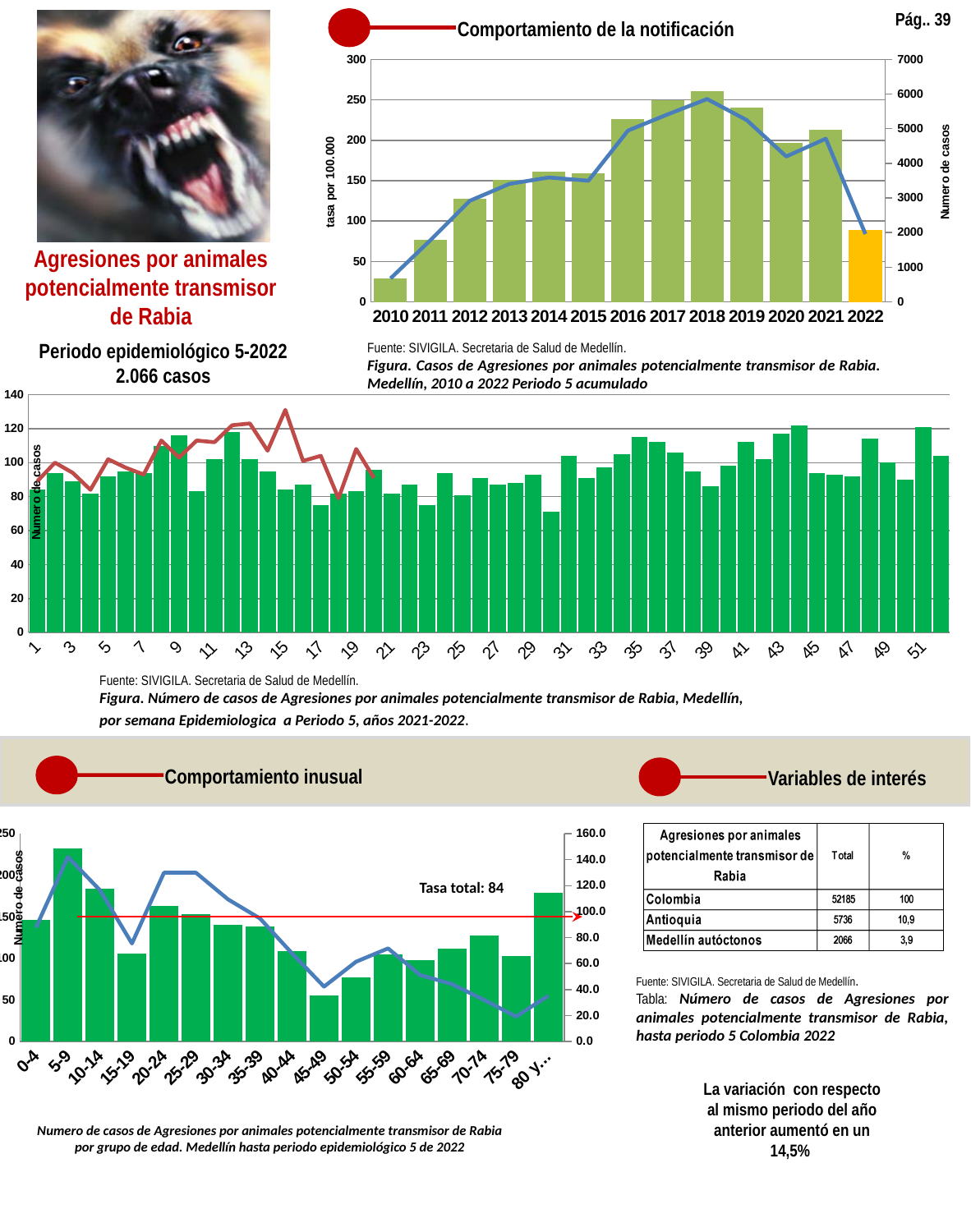
In the 'Comportamiento de la notificación' chart, which year's bar is coloured differently (orange) from the others? 2022 How many age groups are shown on the x axis of the bottom-left chart? 17 In the 'Comportamiento de la notificación' chart, which year has the shortest bar? 2010 In the bottom-left chart by age group, which age group has the tallest bar? 5-9 In the bottom-left chart by age group, which bar is taller: 5-9 or 15-19? 5-9 In the 'Comportamiento de la notificación' chart, is the line value (tasa por 100.000) for 2018 greater or less than 200? greater In the 'Comportamiento de la notificación' chart, which year has the tallest bar? 2018 In the 'Comportamiento de la notificación' chart, do the bars rise or fall from 2010 to 2018? rise In the bottom-left chart by age group, is the bar for 45-49 greater or less than 100? less How many years are shown on the x axis of the 'Comportamiento de la notificación' chart? 13 In the bottom-left chart by age group, which age group has the shortest bar? 75-79 What value is given for 'Tasa total' in the bottom-left chart by age group? 84